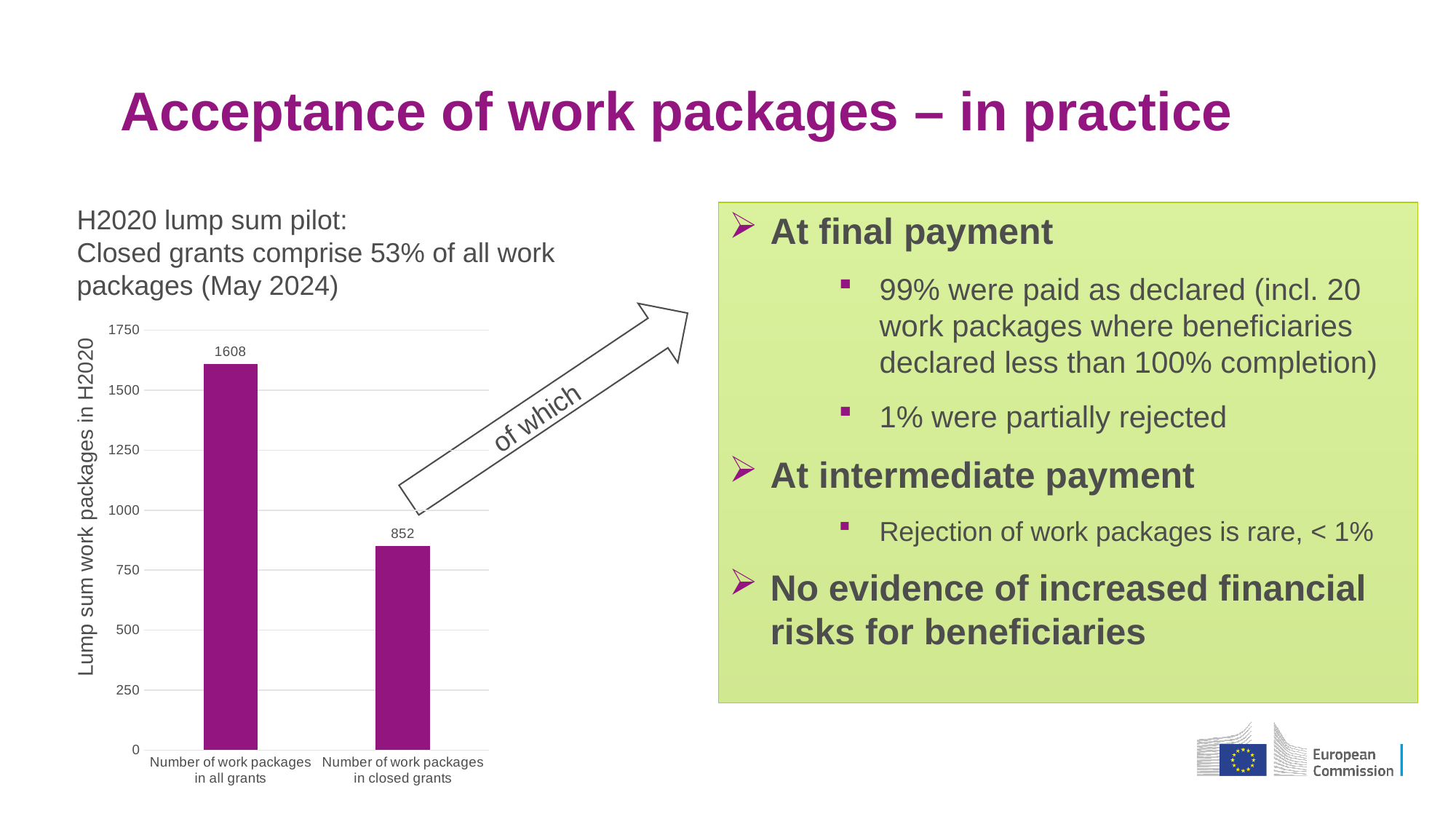
Is the value for work packages in closed grants greater or less than 1000? less What is the maximum value shown on the vertical axis of the chart? 1750 What is the difference between the number of work packages in all grants and in closed grants? 756 What is the number of work packages in all grants? 1608 What is the number of work packages in closed grants? 852 Which category has the higher value? Number of work packages in all grants What is the label of the vertical axis of the chart? Lump sum work packages in H2020 How many bars are shown in the chart? 2 Which category has the lower value? Number of work packages in closed grants Is the value for work packages in all grants greater or less than 1500? greater What type of chart is shown on the slide? Bar chart